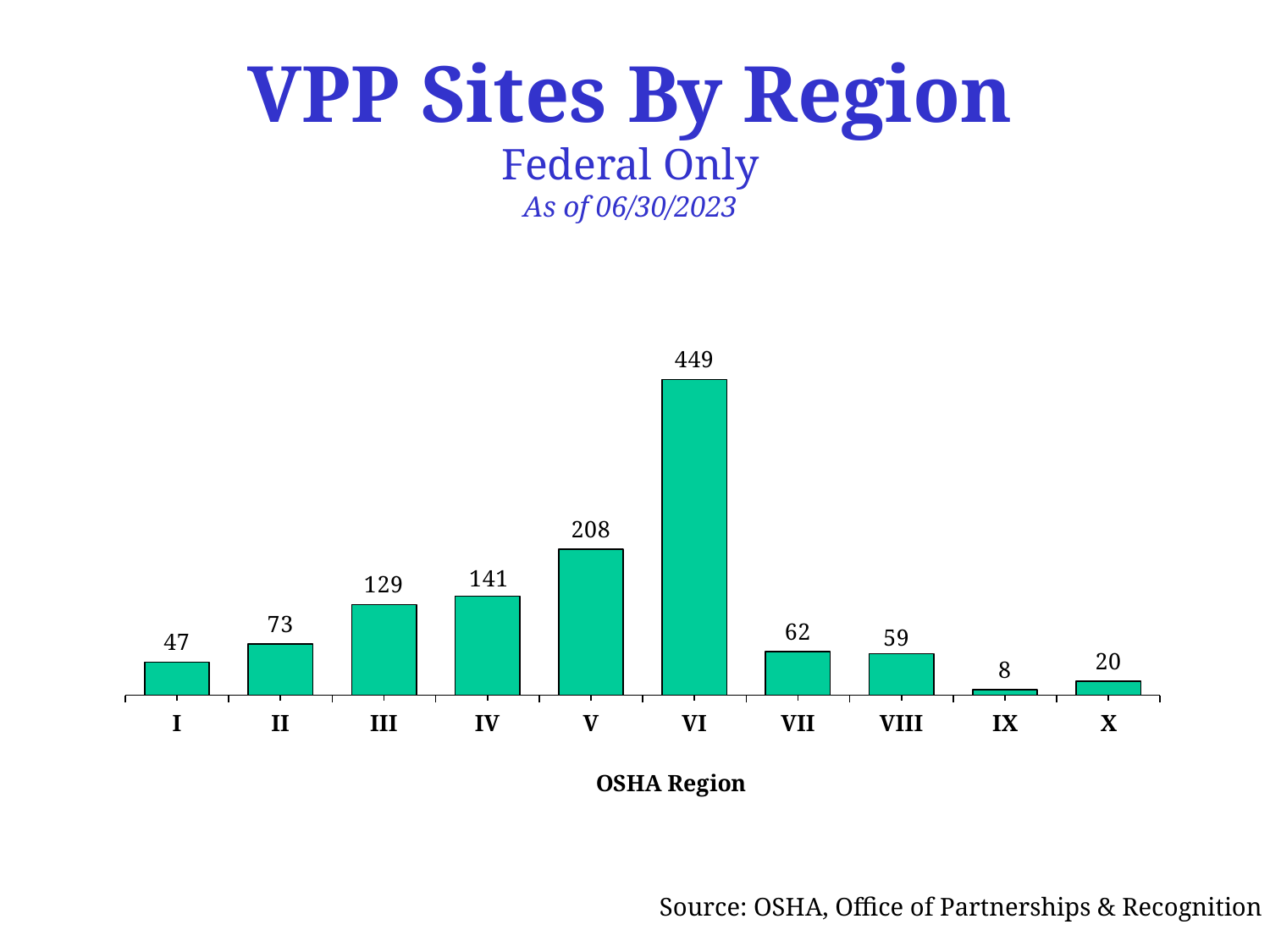
What is the value shown for Region III? 129 How many VPP sites does Region X have? 20 What kind of chart is used to show VPP sites by region? Bar chart How many VPP sites are in OSHA Region VI? 449 Which OSHA region has the highest number of VPP sites? VI Which OSHA region has the lowest number of VPP sites? IX Which has more VPP sites, Region VII or Region VIII? VII What is the difference between the values for Region VI and Region V? 241 Which has more VPP sites, Region I or Region II? II What is the x-axis title of the chart? OSHA Region How many more VPP sites does Region IV have than Region III? 12 How many OSHA regions are shown on the x axis? 10